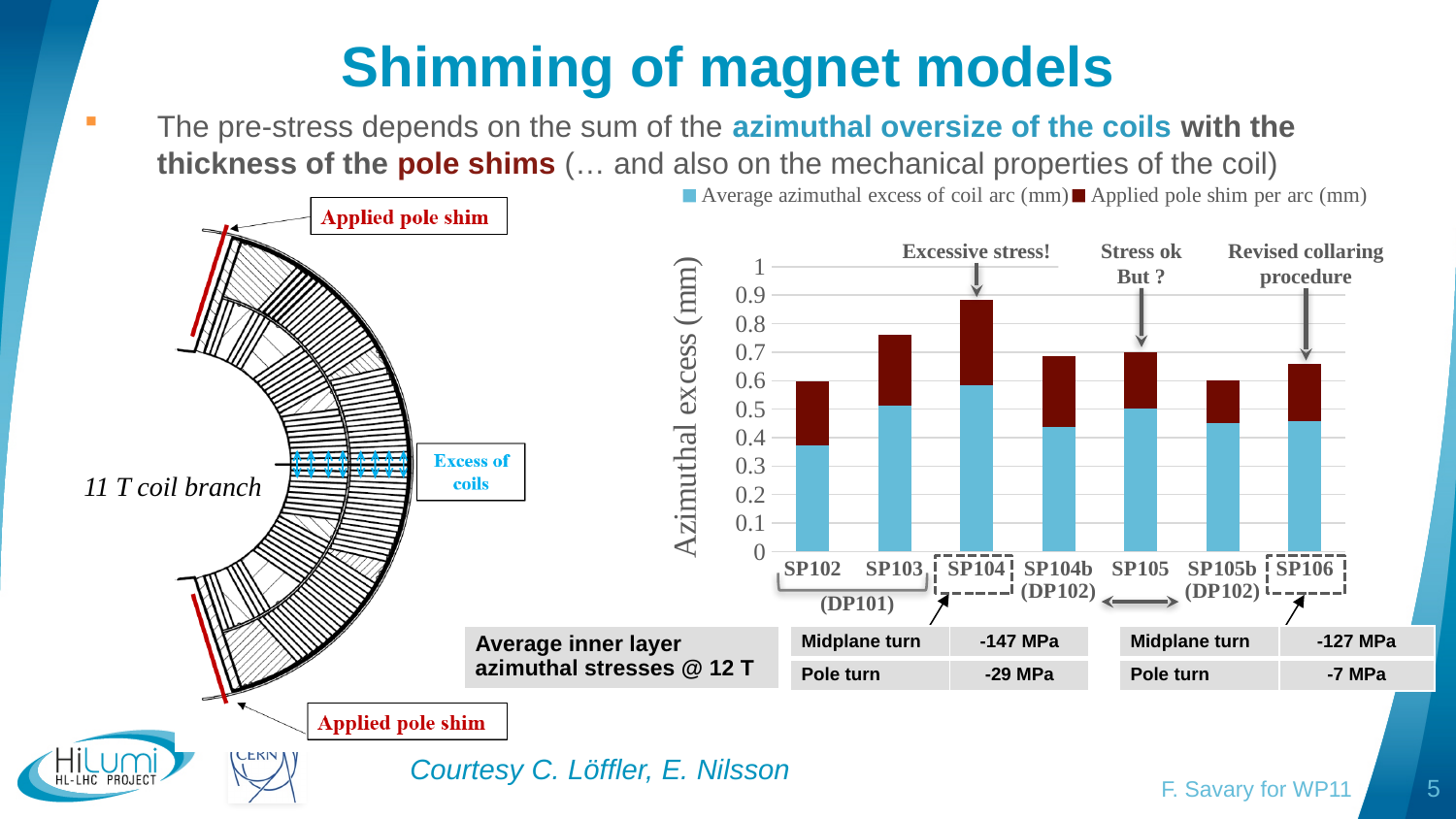
How many series does the chart legend list? 2 Which has a larger total bar, SP104 or SP105b? SP104 What is the title of the chart's vertical axis? Azimuthal excess (mm) Which magnet model has the largest 'Average azimuthal excess of coil arc (mm)' (light blue) segment? SP104 What kind of chart is shown on the slide? Stacked bar chart Is the total bar height for SP102 greater or less than 0.7? less Is the 'Average azimuthal excess of coil arc (mm)' value for SP102 greater or less than 0.4? less How many magnet models (categories) are shown on the x axis of the chart? 7 Is the total bar height for SP103 greater or less than 0.7? greater Which magnet model has the highest total azimuthal excess in the chart? SP104 Which has a larger total bar, SP103 or SP104b? SP103